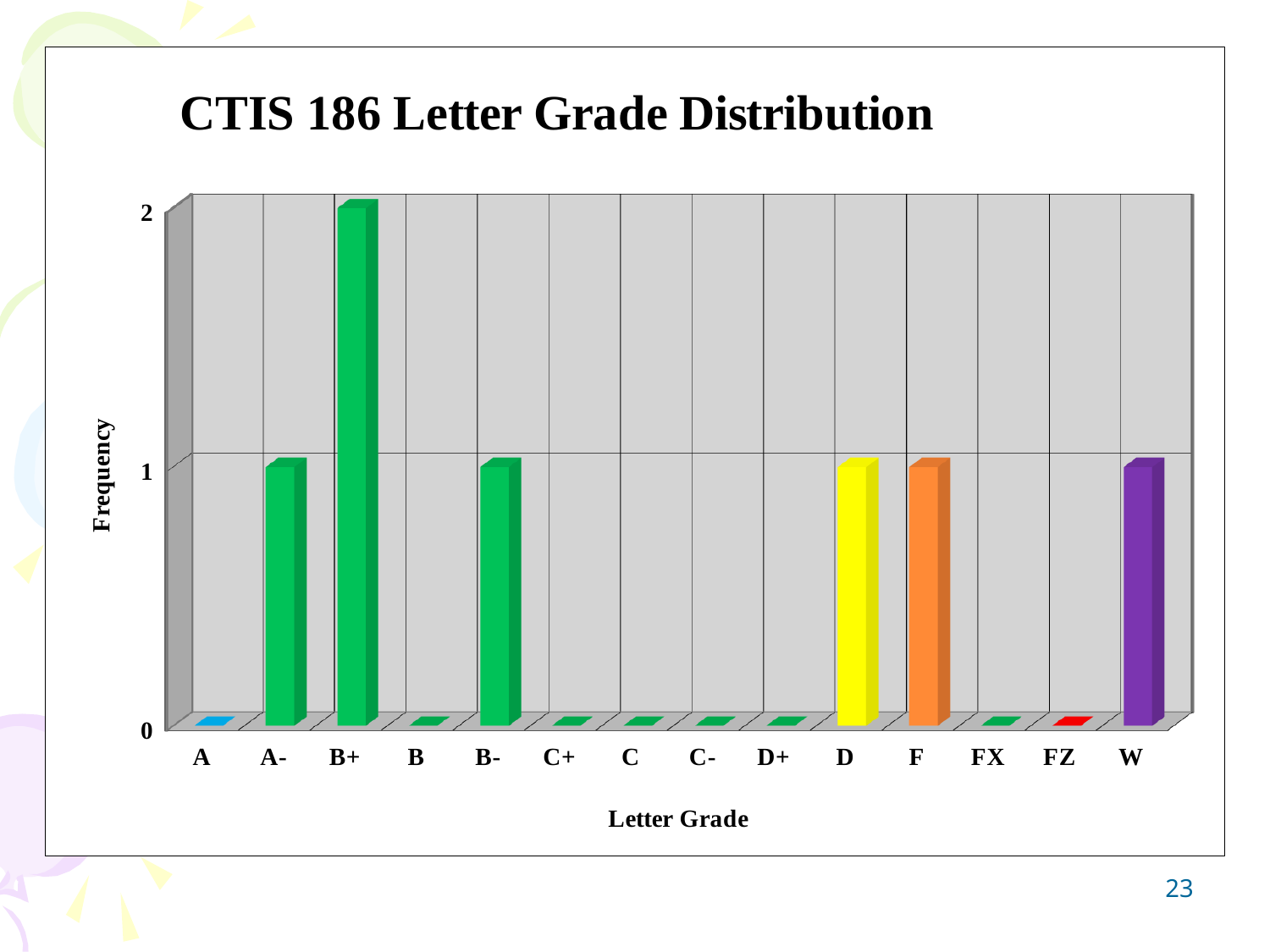
Which letter grade has the highest frequency? B+ What is the frequency for C? 0 What is the frequency for A-? 1 What is the label of the y axis? Frequency How many letter grade categories are shown on the x axis? 14 Which has a higher frequency, B+ or F? B+ What is the frequency for B+? 2 Which has a higher frequency, B- or B? B- What is the title of the chart? CTIS 186 Letter Grade Distribution What kind of chart is shown on the slide? Bar chart What is the frequency for W? 1 What is the difference in frequency between B+ and D? 1